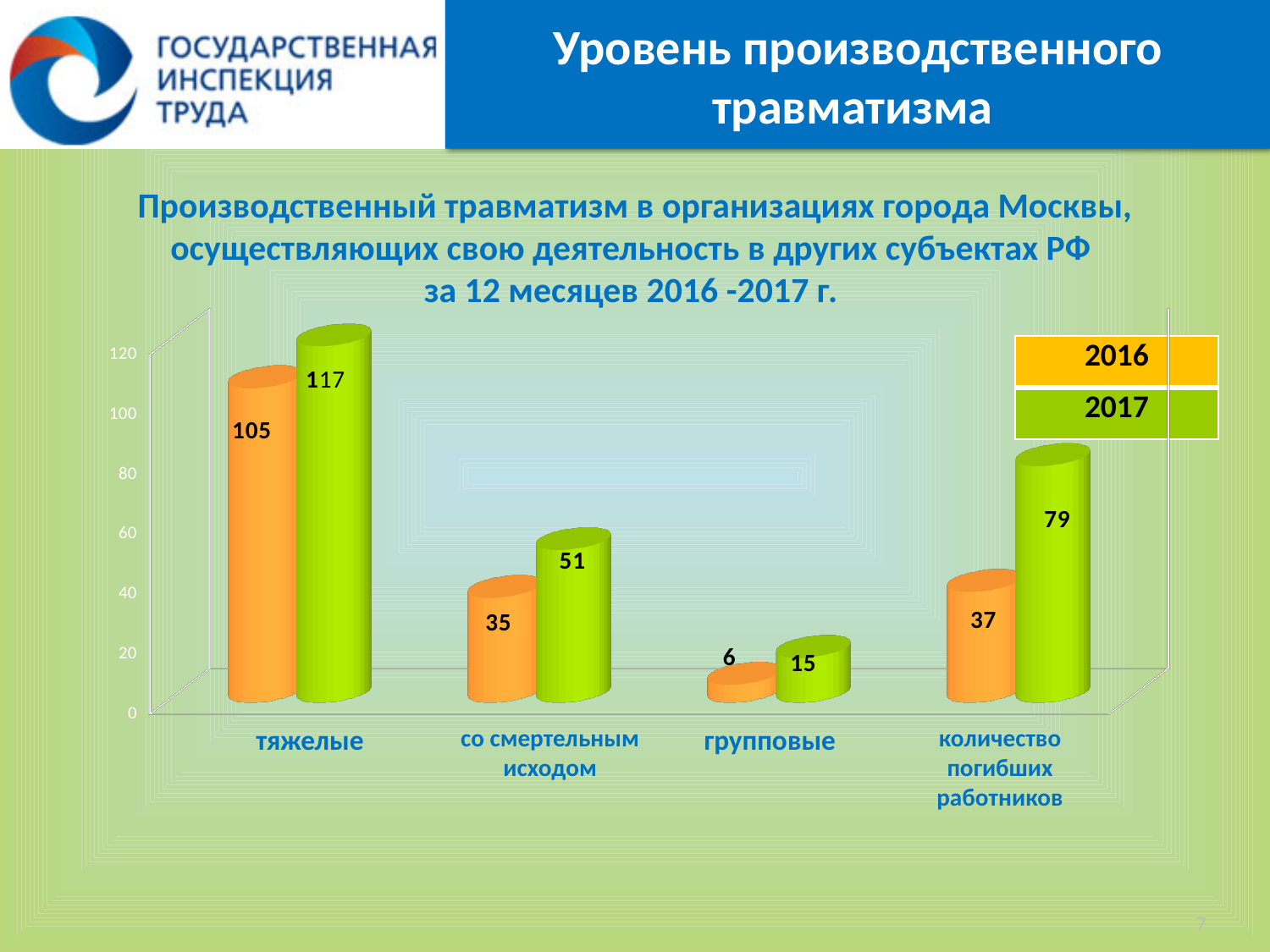
What is the difference between the 2017 and 2016 values for "тяжелые"? 12 What is the 2017 value for "количество погибших работников"? 79 How many series does the legend list? 2 What is the difference between the 2017 and 2016 values for "количество погибших работников"? 42 Which category has the lowest 2017 value? групповые What is the 2017 value for the category "тяжелые"? 117 How many categories are shown on the x axis? 4 Which is larger for "со смертельным исходом": the 2016 value or the 2017 value? 2017 What is the 2016 value for the category "групповые"? 6 Which category has the highest 2016 value? тяжелые What is the 2016 value for the category "со смертельным исходом"? 35 What kind of chart is shown on the slide? bar chart